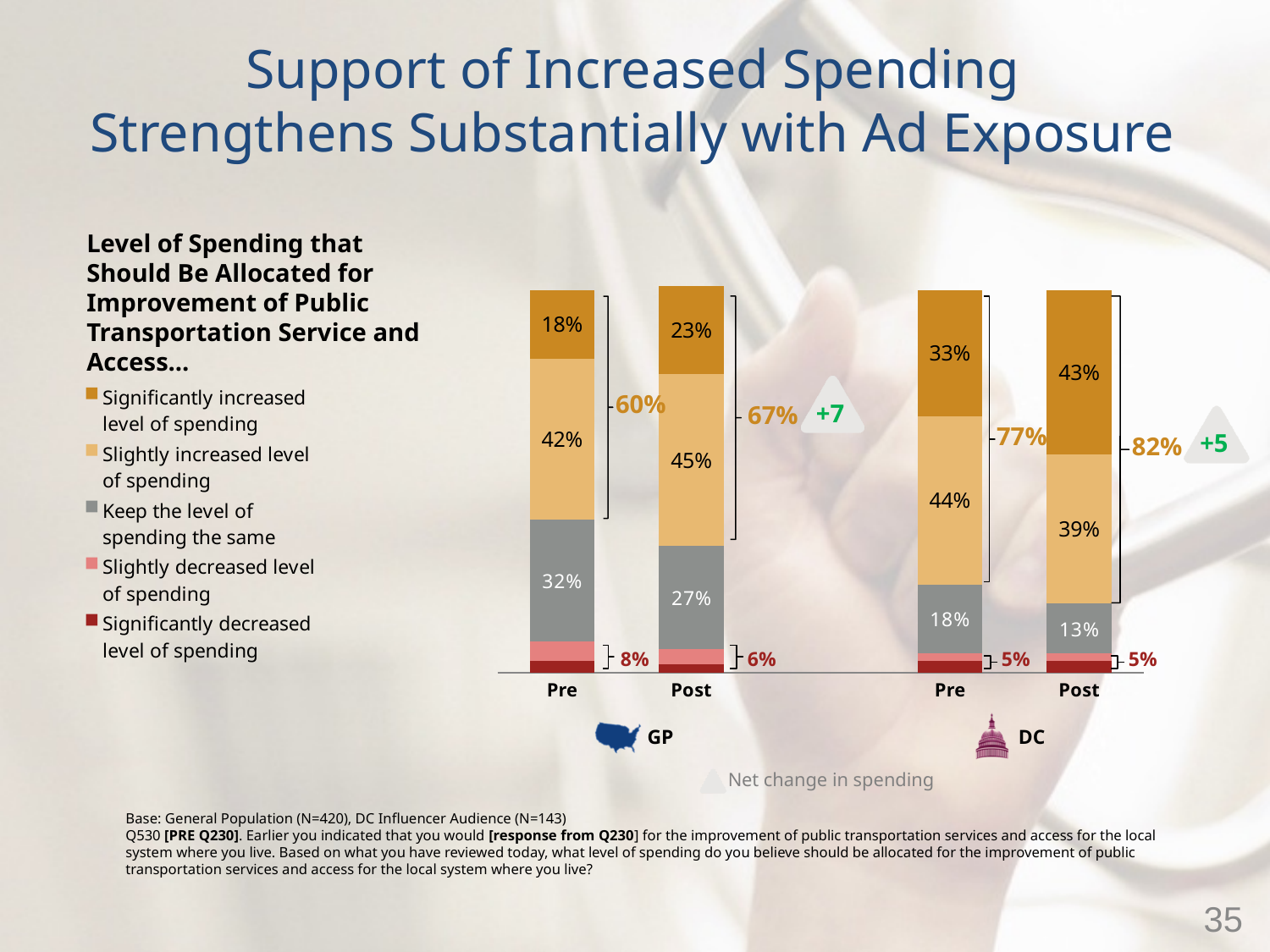
Which bar has the lowest share for 'Keep the level of spending the same'? DC Post What is the difference between the 'Slightly increased level of spending' shares for GP Post and GP Pre? 3 percentage points What percentage of the DC Post group chose 'Slightly increased level of spending'? 39% How many response categories does the legend list? 5 Which bar has the highest share for 'Significantly increased level of spending'? DC Post What net change in spending support is shown for the DC audience from Pre to Post? +5 How many bars are plotted in the chart? 4 Which is larger: the 'Significantly increased' share for GP Post or for DC Pre? DC Pre What is the combined share of increased spending (significantly plus slightly) shown for the DC Pre bar? 77% What kind of chart is shown on the slide? Stacked bar chart What percentage of the GP Pre group chose 'Significantly increased level of spending'? 18% What percentage of the GP Post group chose 'Keep the level of spending the same'? 27%